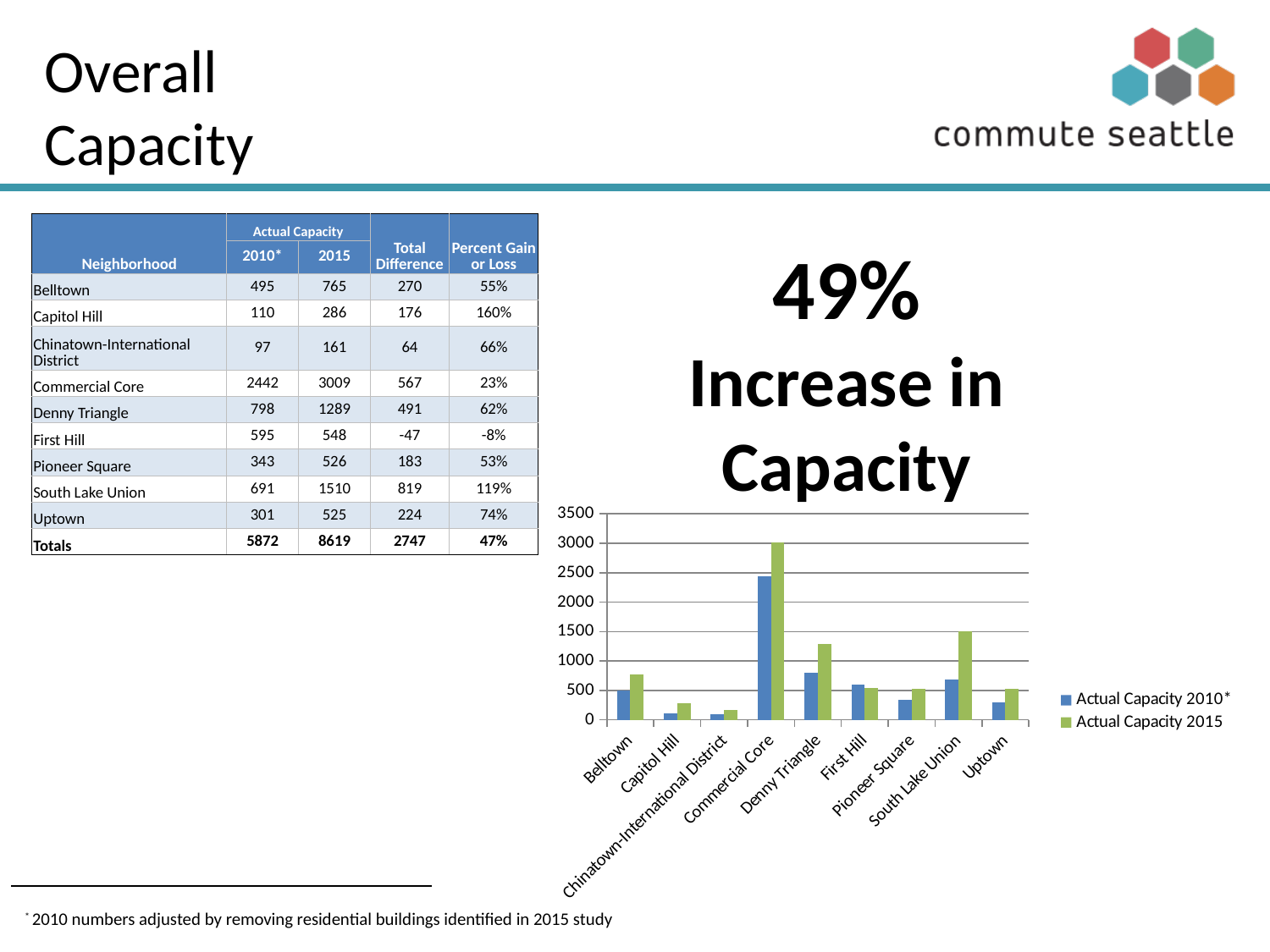
Which is larger in the chart: the Actual Capacity 2010* bar for Commercial Core or the Actual Capacity 2015 bar for South Lake Union? Actual Capacity 2010* for Commercial Core How many neighborhoods are plotted along the x axis of the chart? 9 In the chart, is the Actual Capacity 2015 value for Commercial Core greater or less than 2500? greater In the chart, is the Actual Capacity 2015 value for South Lake Union greater or less than 1000? greater Which neighborhood has the highest Actual Capacity 2015 bar in the chart? Commercial Core In the chart, is the Actual Capacity 2015 value for First Hill greater or less than 1000? less For Denny Triangle, which bar is taller in the chart: Actual Capacity 2010* or Actual Capacity 2015? Actual Capacity 2015 How many series does the chart's legend list? 2 Which neighborhood has the highest Actual Capacity 2010* bar in the chart? Commercial Core What are the two legend entries of the chart? Actual Capacity 2010* and Actual Capacity 2015 What kind of chart is shown on the slide? bar chart According to the table on the slide, what is the 2015 Actual Capacity for Belltown? 765